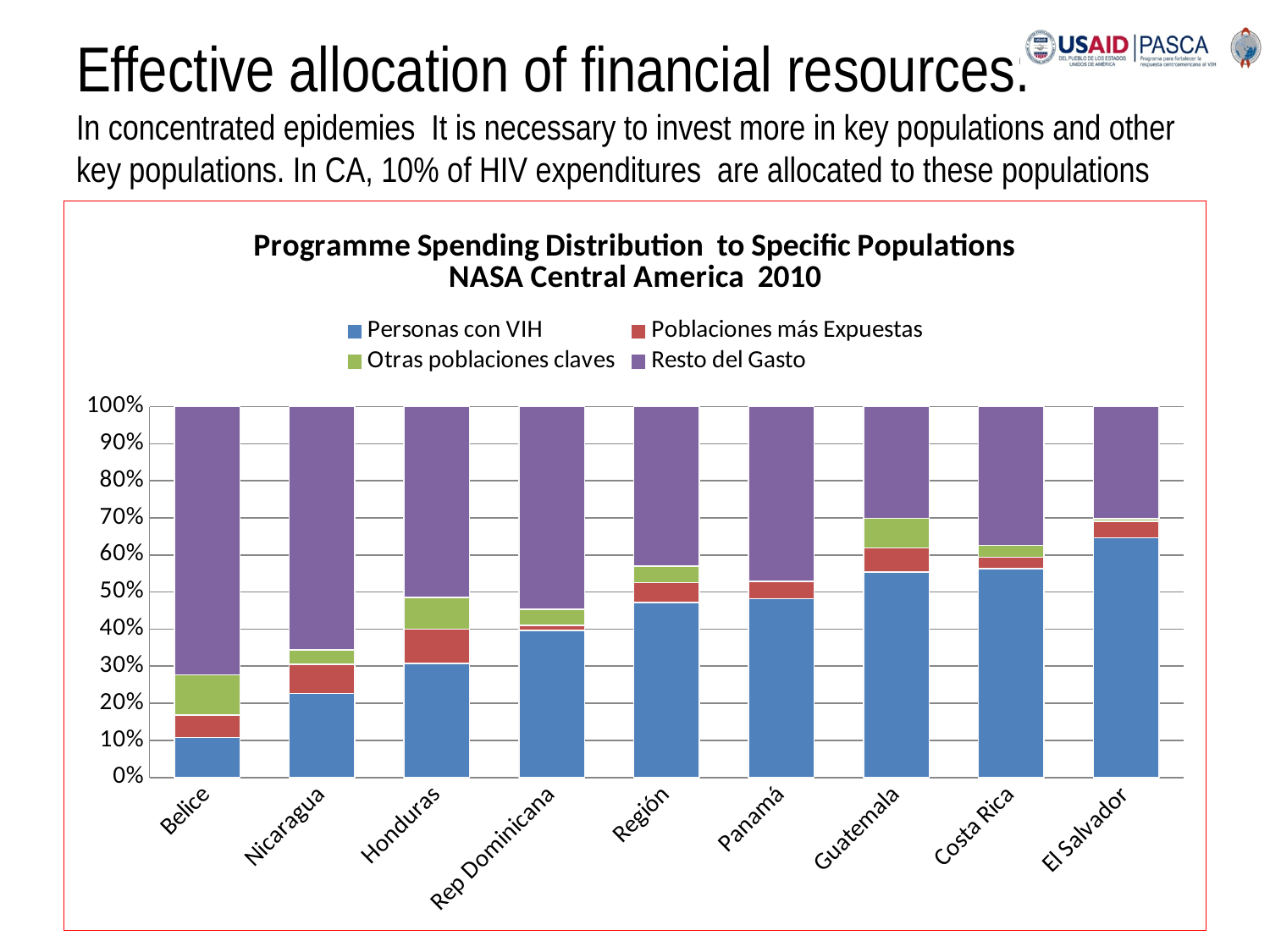
Which has a larger Personas con VIH share, Honduras or Guatemala? Guatemala Which legend entry is shown in purple? Resto del Gasto Which category has the highest share for Personas con VIH? El Salvador What is the title of the chart? Programme Spending Distribution to Specific Populations NASA Central America 2010 How many countries/regions are shown along the x axis of the chart? 9 How many series does the chart's legend list? 4 Is the Personas con VIH share for Guatemala greater or less than 50%? greater Is the Personas con VIH share for Nicaragua greater or less than 30%? less Is the Personas con VIH share for El Salvador greater or less than 60%? greater Which category has the lowest share for Personas con VIH? Belice What kind of chart is shown on the slide? Stacked bar chart